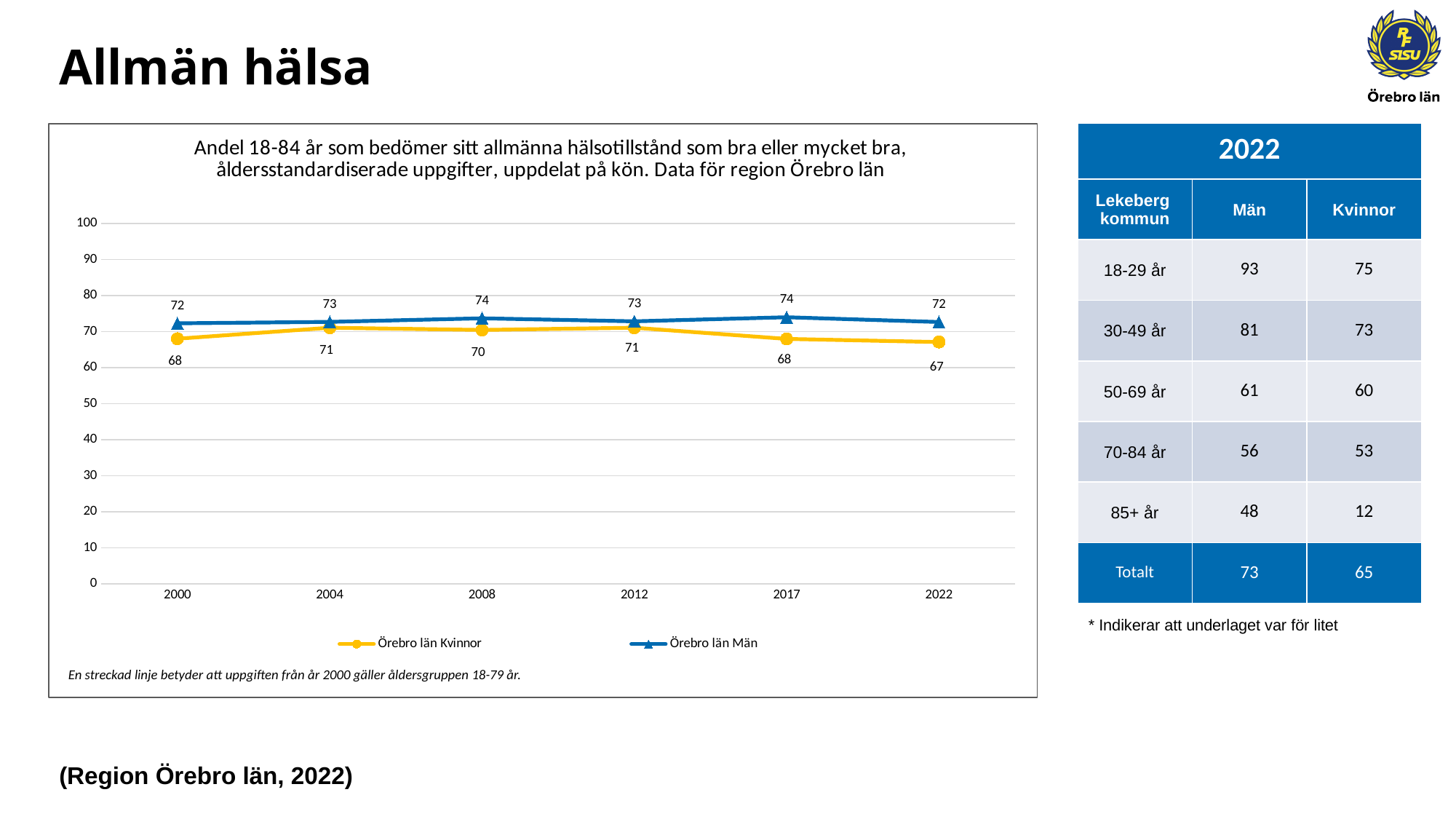
Does the value for Örebro län Kvinnor rise or fall from 2012 to 2022? fall Which colour is used for the Örebro län Män series? blue Which series has the higher value in 2000, Örebro län Kvinnor or Örebro län Män? Örebro län Män What kind of chart is shown? line chart How many series does the legend list? 2 What is the value for Örebro län Kvinnor in 2000? 68 How many years are shown on the x axis? 6 In which year is the value for Örebro län Kvinnor lowest? 2022 What is the value for Örebro län Män in 2017? 74 Is the value for Örebro län Män in 2008 greater or less than 70? greater What is the value for Örebro län Kvinnor in 2022? 67 What is the difference between Örebro län Män and Örebro län Kvinnor in 2022? 5